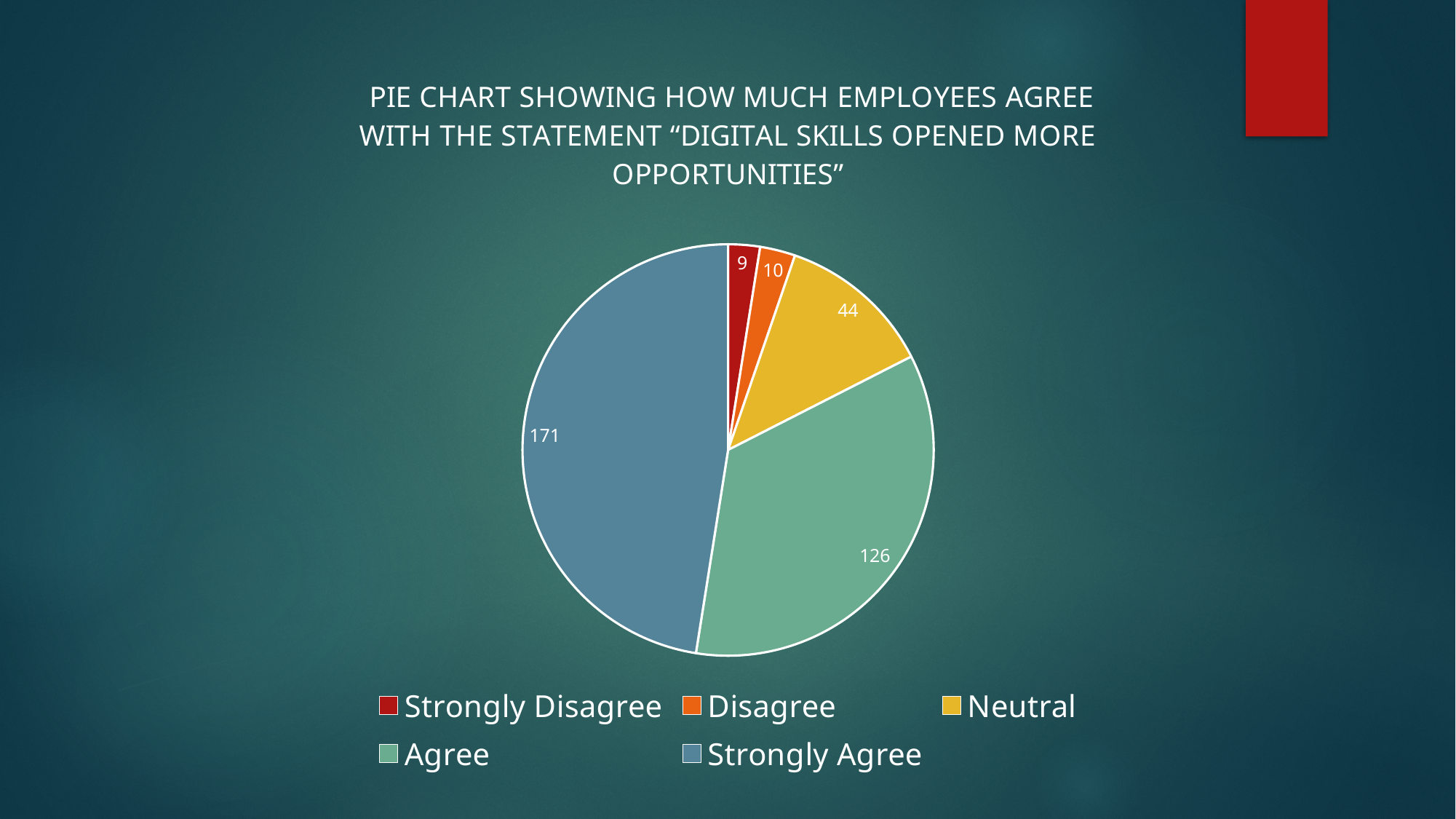
Which response category has the largest slice? Strongly Agree Which is larger, the "Neutral" slice or the "Disagree" slice? Neutral Which response category has the smallest slice? Strongly Disagree What is the total of all the slices in the pie chart? 360 What type of chart is shown on the slide? Pie chart What colour is the "Neutral" slice in the pie chart? Yellow What share of the pie does the "Agree" slice represent? 35% What is the value for the "Disagree" slice? 10 How many employees responded "Strongly Agree"? 171 How many response categories does the pie chart show? 5 What is the difference between the "Strongly Agree" and "Agree" values? 45 What is the value for the "Neutral" slice? 44